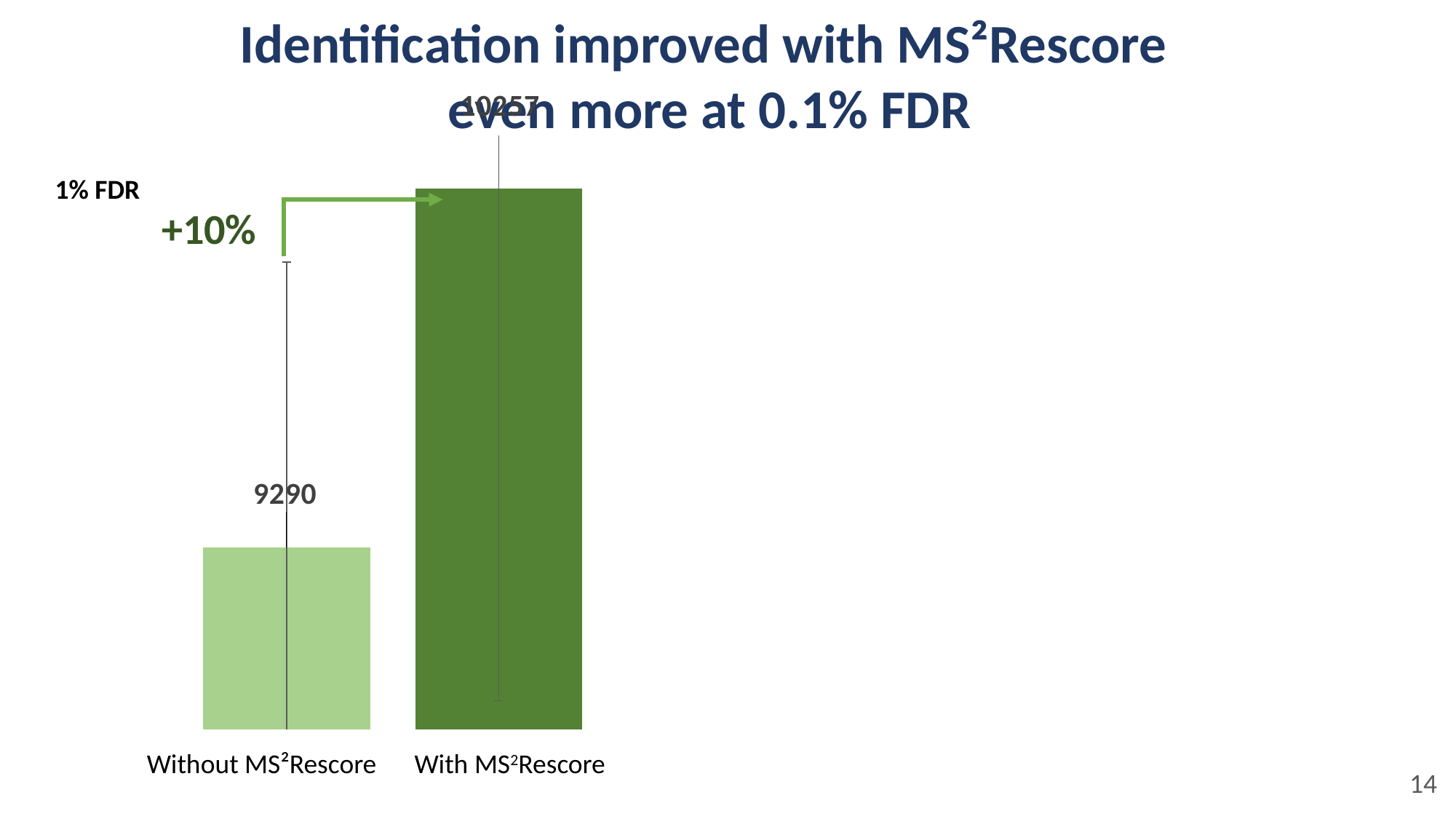
How many bars are shown in the chart? 2 What kind of chart is shown on the slide? bar chart What percentage improvement is annotated between the two bars? +10% What is the value for Without MS²Rescore? 9290 Which is larger, the value for With MS²Rescore or Without MS²Rescore? With MS²Rescore Which category has the lowest value? Without MS²Rescore What FDR level is labelled on the chart? 1% FDR Do the values rise or fall from Without MS²Rescore to With MS²Rescore? rise Which category has the highest value? With MS²Rescore